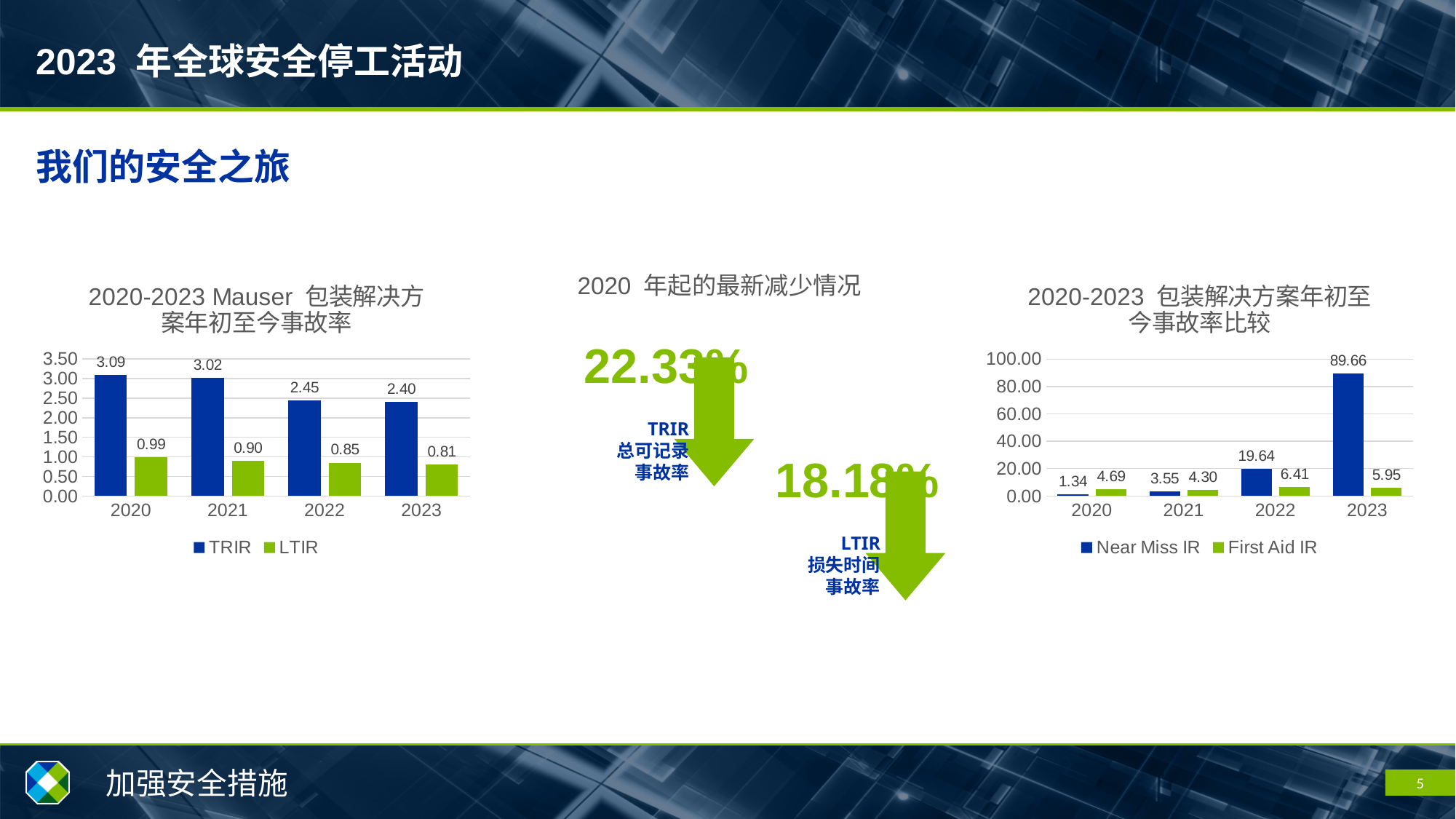
In the right chart, which is larger in 2020: Near Miss IR or First Aid IR? First Aid IR In the left chart, does the TRIR series rise or fall from 2020 to 2023? fall In the right chart, what is the Near Miss IR value for 2023? 89.66 In the left chart, how many series does the legend list? 2 In the right chart, how many years are shown on the x axis? 4 In the left chart, what is the difference between the TRIR values for 2020 and 2023? 0.69 In the left chart, what is the TRIR value for 2020? 3.09 In the left chart, what is the LTIR value for 2023? 0.81 What type of chart is the right chart? bar chart In the right chart, which year has the highest Near Miss IR value? 2023 In the right chart, what is the First Aid IR value for 2022? 6.41 In the left chart, which year has the lowest TRIR value? 2023